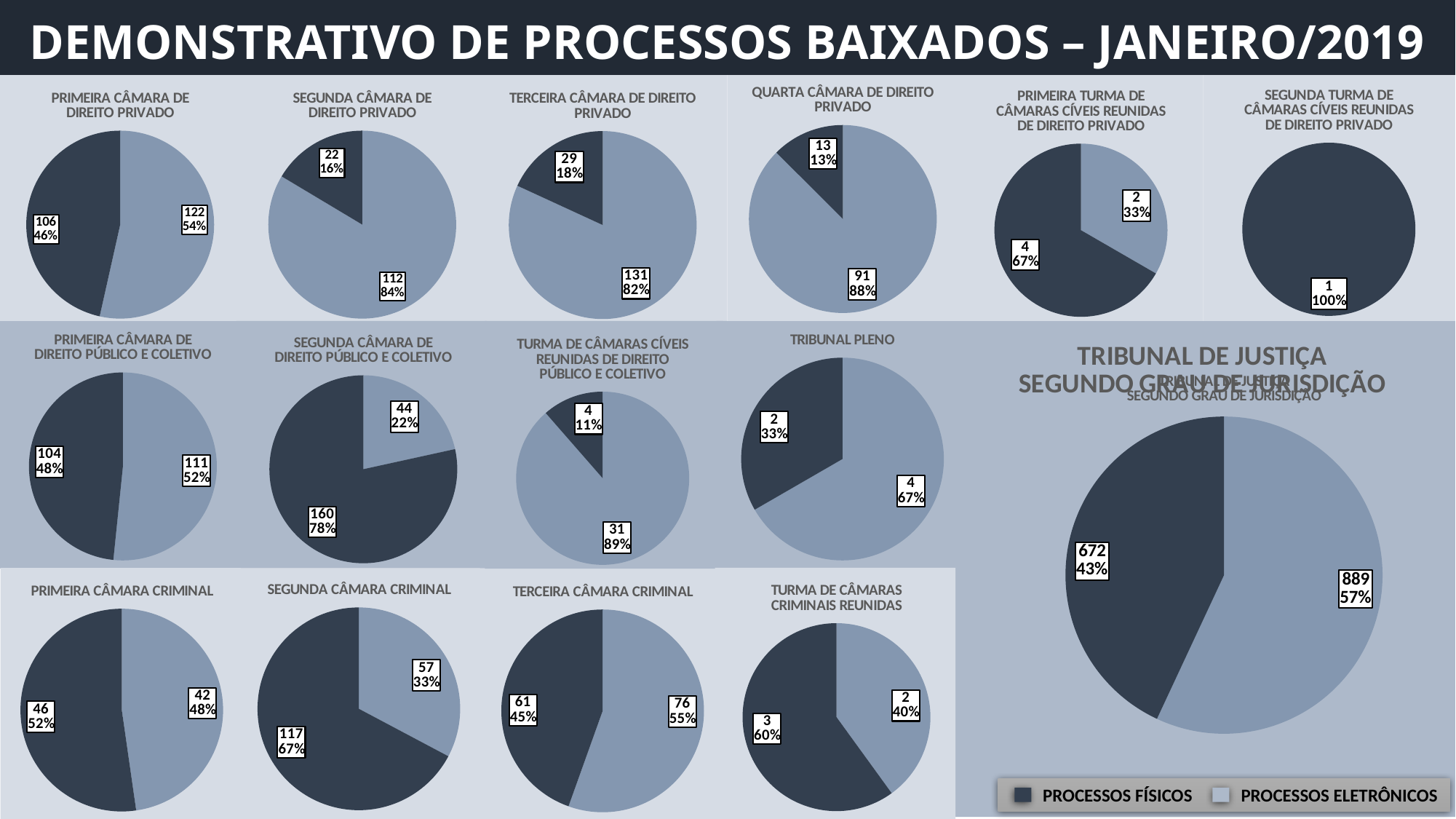
In the 'Quarta Câmara de Direito Privado' chart, what is the total number of processes shown? 104 In the 'Segunda Câmara de Direito Público e Coletivo' chart, what is the difference between Processos Físicos and Processos Eletrônicos? 116 In the 'Turma de Câmaras Cíveis Reunidas de Direito Público e Coletivo' chart, what is the value for Processos Eletrônicos? 31 In the 'Segunda Turma de Câmaras Cíveis Reunidas de Direito Privado' chart, what percentage is Processos Físicos? 100% In the 'Segunda Câmara Criminal' chart, which is larger, Processos Físicos or Processos Eletrônicos? Processos Físicos In the 'Terceira Câmara Criminal' chart, which slice is larger, Processos Físicos or Processos Eletrônicos? Processos Eletrônicos In the 'Segunda Câmara de Direito Privado' chart, what is the value for Processos Físicos? 22 What kind of chart is used for 'Primeira Câmara Criminal'? Pie chart How many series does the legend at the bottom right of the slide list? 2 In the 'Tribunal de Justiça Segundo Grau de Jurisdição' chart, how many Processos Eletrônicos are shown? 889 In the 'Tribunal de Justiça Segundo Grau de Jurisdição' chart, what share of the pie is Processos Físicos? 43% In the 'Terceira Câmara de Direito Privado' chart, what percentage is Processos Eletrônicos? 82%